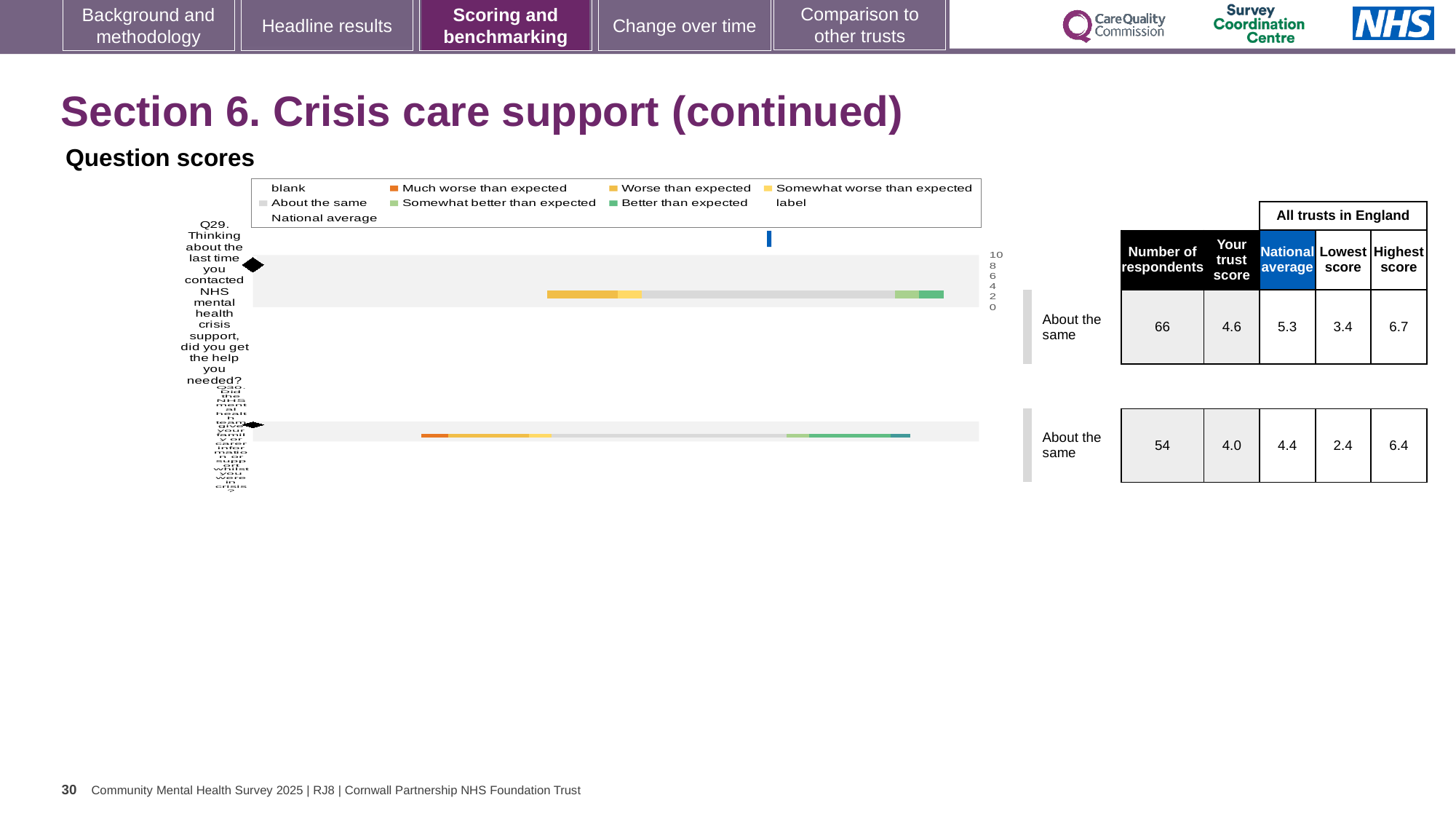
What is the highest score among all trusts in England for Q29? 6.7 How many respondents answered Q29? 66 What is the difference between the highest and lowest scores for Q29? 3.3 What is the lowest score among all trusts in England for Q30? 2.4 What kind of chart is used to show the question scores on this slide? bar chart What benchmark category is shown for Q30? About the same What is the trust score for Q30? 4.0 What is the trust score for Q29 (Thinking about the last time you contacted NHS mental health crisis support, did you get the help you needed?)? 4.6 What is the difference between the national average and the trust score for Q30? 0.4 For Q29, which is larger: the trust score or the national average? national average How many questions are plotted in the question scores chart? 2 What is the national average score for Q29? 5.3